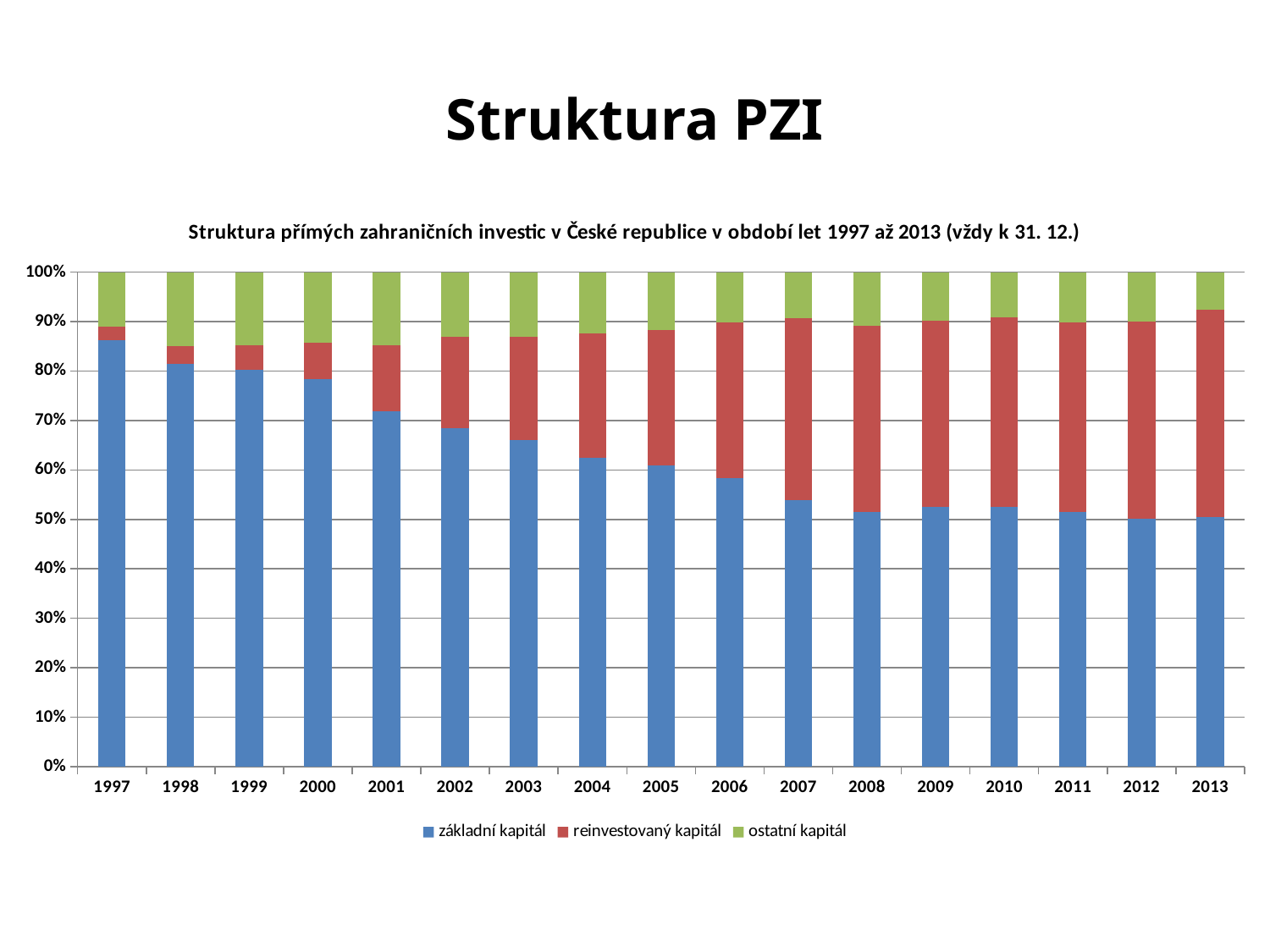
What are the three series listed in the chart legend? základní kapitál, reinvestovaný kapitál, ostatní kapitál Does the share of základní kapitál rise or fall from 1997 to 2013? Fall Is the share of základní kapitál in 2013 greater or less than 60%? less In 2013, which is larger, the share of základní kapitál or the share of reinvestovaný kapitál? základní kapitál Which year has a larger share of základní kapitál, 2001 or 2006? 2001 How many years are shown on the x axis of the chart? 17 How many series does the chart legend list? 3 Is the share of základní kapitál in 1997 greater or less than 80%? greater What is the title of the chart? Struktura přímých zahraničních investic v České republice v období let 1997 až 2013 (vždy k 31. 12.) In which year is the share of základní kapitál the highest? 1997 What kind of chart is shown on the slide? Stacked bar chart Is the share of reinvestovaný kapitál in 1997 greater or less than 10%? less